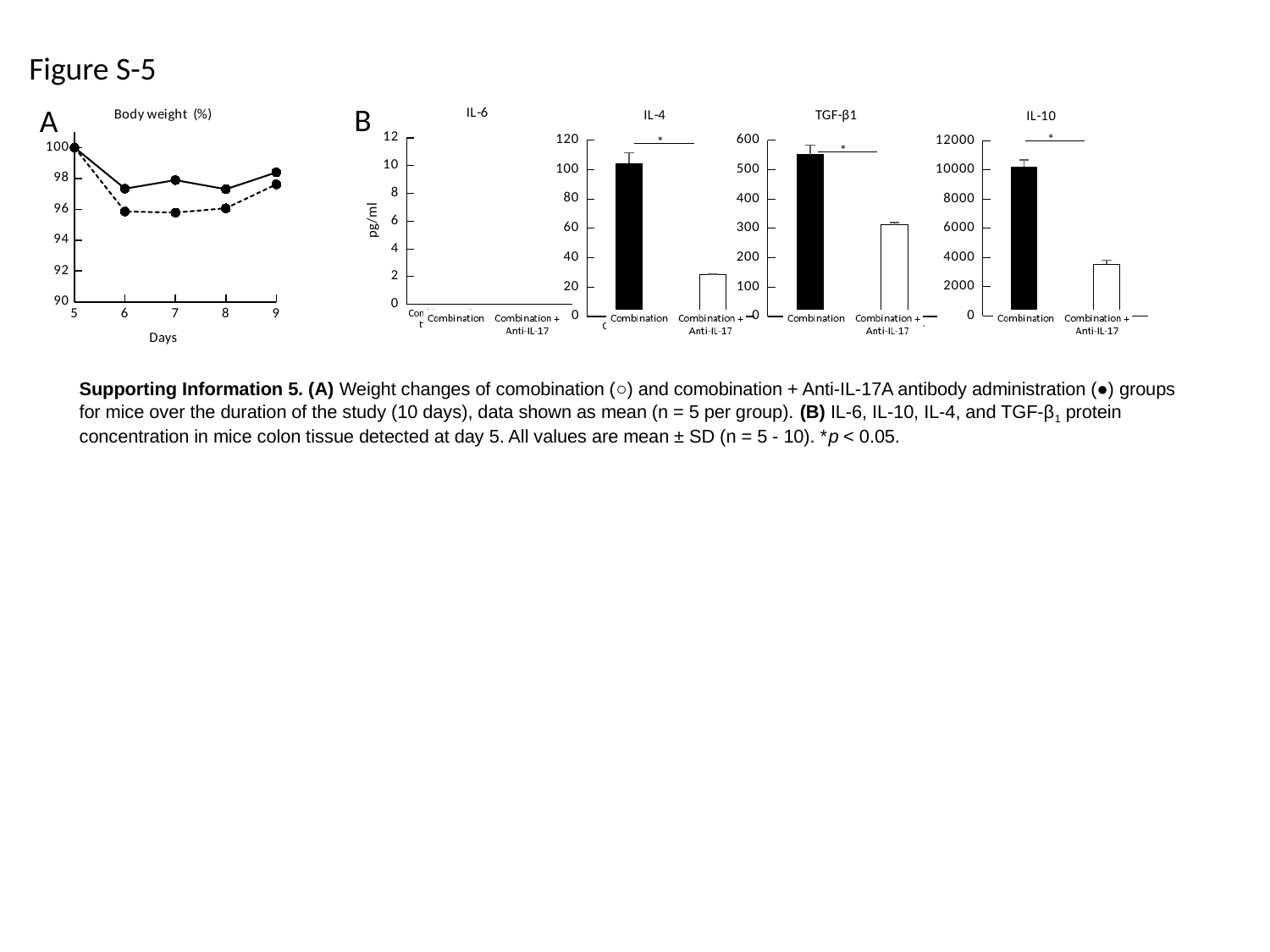
What kind of chart is the IL-4 chart? bar chart In the TGF-β1 chart, is the value for Combination greater or less than 500? greater In the IL-4 chart, is the value for Combination + Anti-IL-17 greater or less than 40? less What kind of chart is the Body weight (%) chart? line chart In the Body weight (%) chart, does body weight rise or fall from day 5 to day 6? fall In the IL-10 chart, how many categories are shown on the x axis? 2 In the IL-10 chart, is the value for Combination greater or less than 8000? greater In the Body weight (%) chart, what is the value for both groups at day 5? 100 In the Body weight (%) chart, how many days are plotted on the x axis? 5 In the IL-4 chart, which category has the higher value, Combination or Combination + Anti-IL-17? Combination